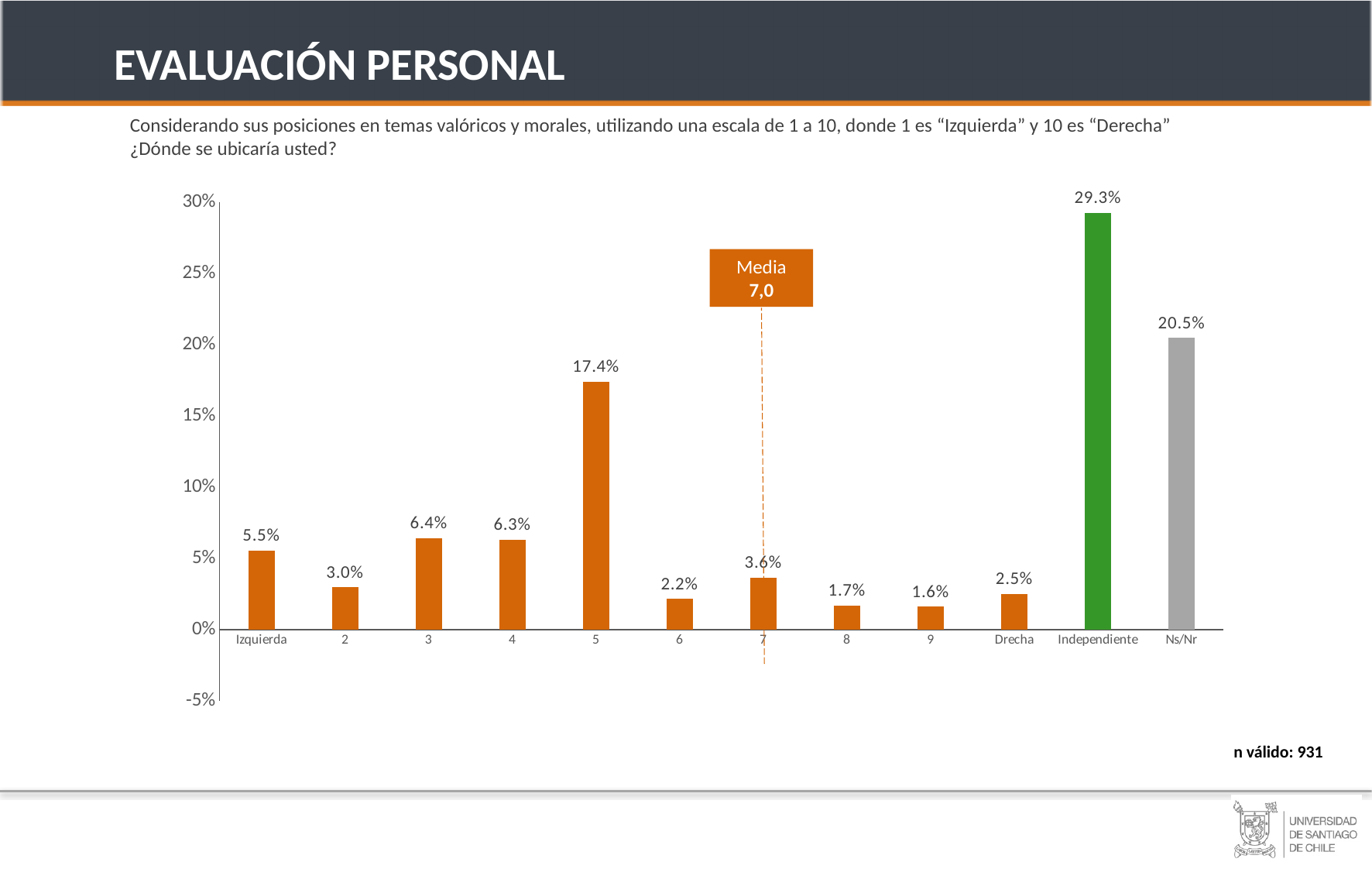
What is the value for Izquierda? 5.5% Is the value for 5 greater or less than 15%? greater What is the value for Ns/Nr? 20.5% What kind of chart is shown on the slide? bar chart What mean (Media) value is shown in the orange box on the chart? 7,0 Which is larger, the value for 3 or the value for 4? 3 Which category has the highest value? Independiente How many categories are shown on the x axis? 12 What is the difference between the values for Independiente and Ns/Nr? 8.8% Which category has the lowest value? 9 What is the value for the category 5? 17.4% What is the value for Independiente? 29.3%